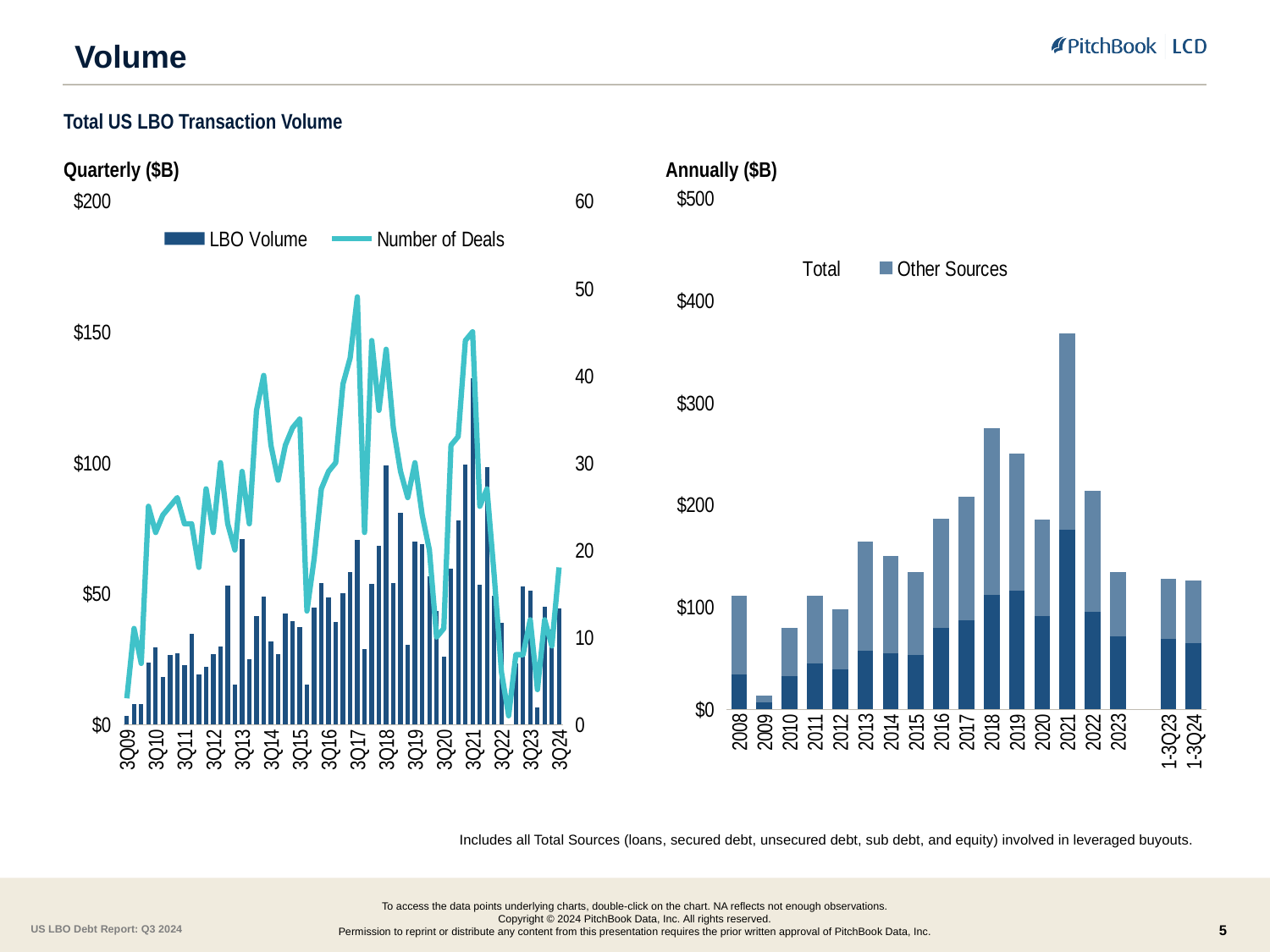
In the Quarterly ($B) chart, is the peak of the Number of Deals line around 3Q17 greater or less than 40? greater How many bars are plotted in the Annually ($B) chart? 18 In the Annually ($B) chart, which year has the tallest stacked bar? 2021 In the Annually ($B) chart, is the total bar for 2021 greater or less than $300? greater In the Annually ($B) chart, is the total bar for 2009 greater or less than $100? less What kind of chart is the Annually ($B) chart? Stacked bar chart How many series does the legend of the Annually ($B) chart list? 2 In the Annually ($B) chart, which year has the shortest stacked bar? 2009 In the Annually ($B) chart, which stacked bar is taller, 2018 or 2021? 2021 What are the two legend entries in the Quarterly ($B) chart? LBO Volume and Number of Deals